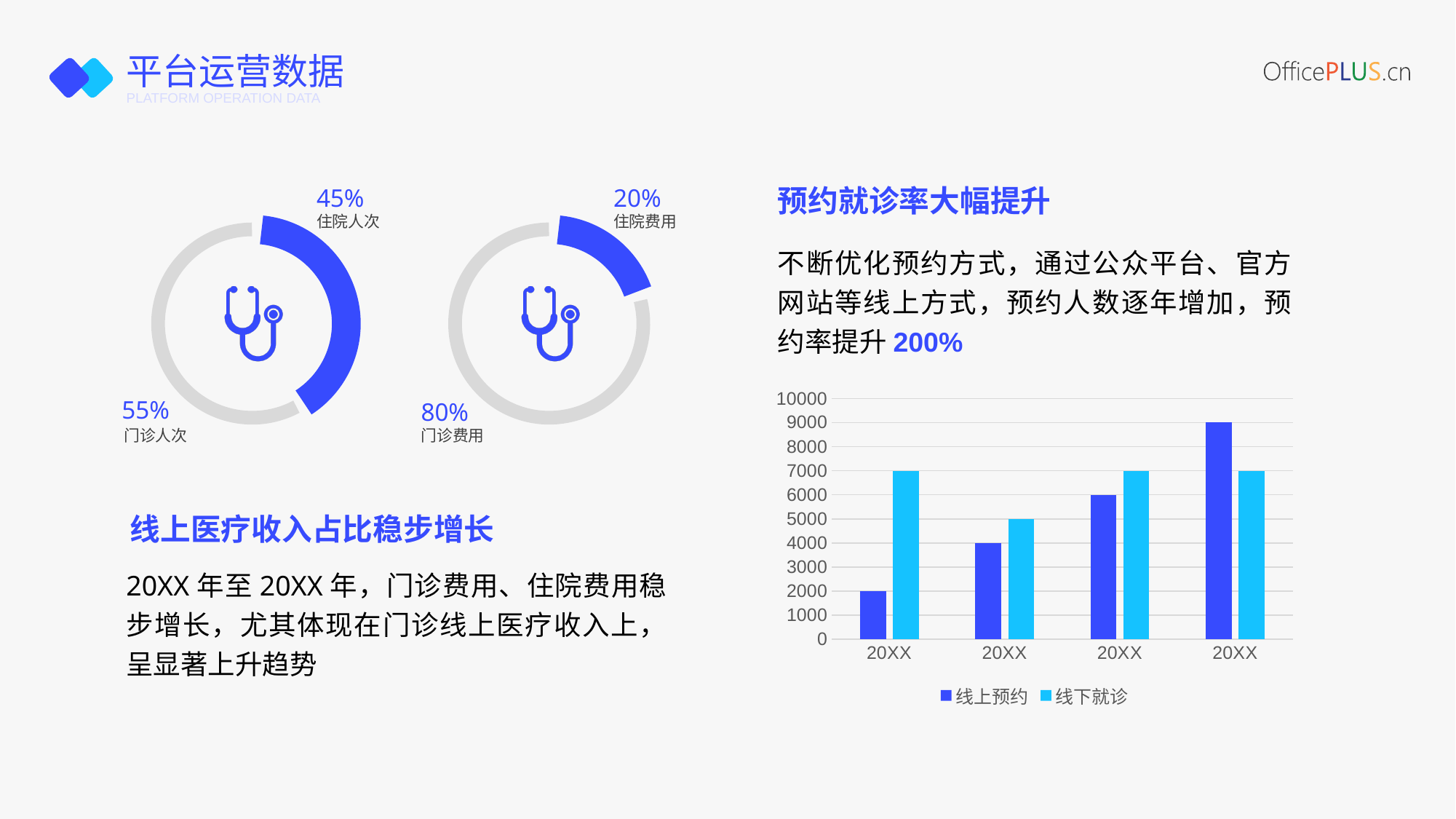
On the left donut chart (住院人次 / 门诊人次), what share is labelled for 门诊人次? 55% What kind of chart is shown on the right side of the slide? Bar chart On the bar chart on the right, what is the value of 线下就诊 for the second 20XX category? 5000 On the bar chart on the right, in the third 20XX category, which is larger: 线上预约 or 线下就诊? 线下就诊 On the bar chart on the right, what is the difference between 线上预约 and 线下就诊 in the first 20XX category? 5000 On the bar chart on the right, how many categories are shown on the x axis? 4 On the bar chart on the right, what is the value of 线上预约 for the first 20XX category? 2000 On the bar chart on the right, what is the value of 线上预约 for the fourth (rightmost) 20XX category? 9000 On the bar chart on the right, which category has the highest 线上预约 value? The fourth (rightmost) 20XX On the bar chart on the right, which category has the lowest 线下就诊 value? The second 20XX On the bar chart on the right, how many series does the legend list? 2 On the bar chart on the right, does the 线上预约 series rise or fall from left to right? Rise